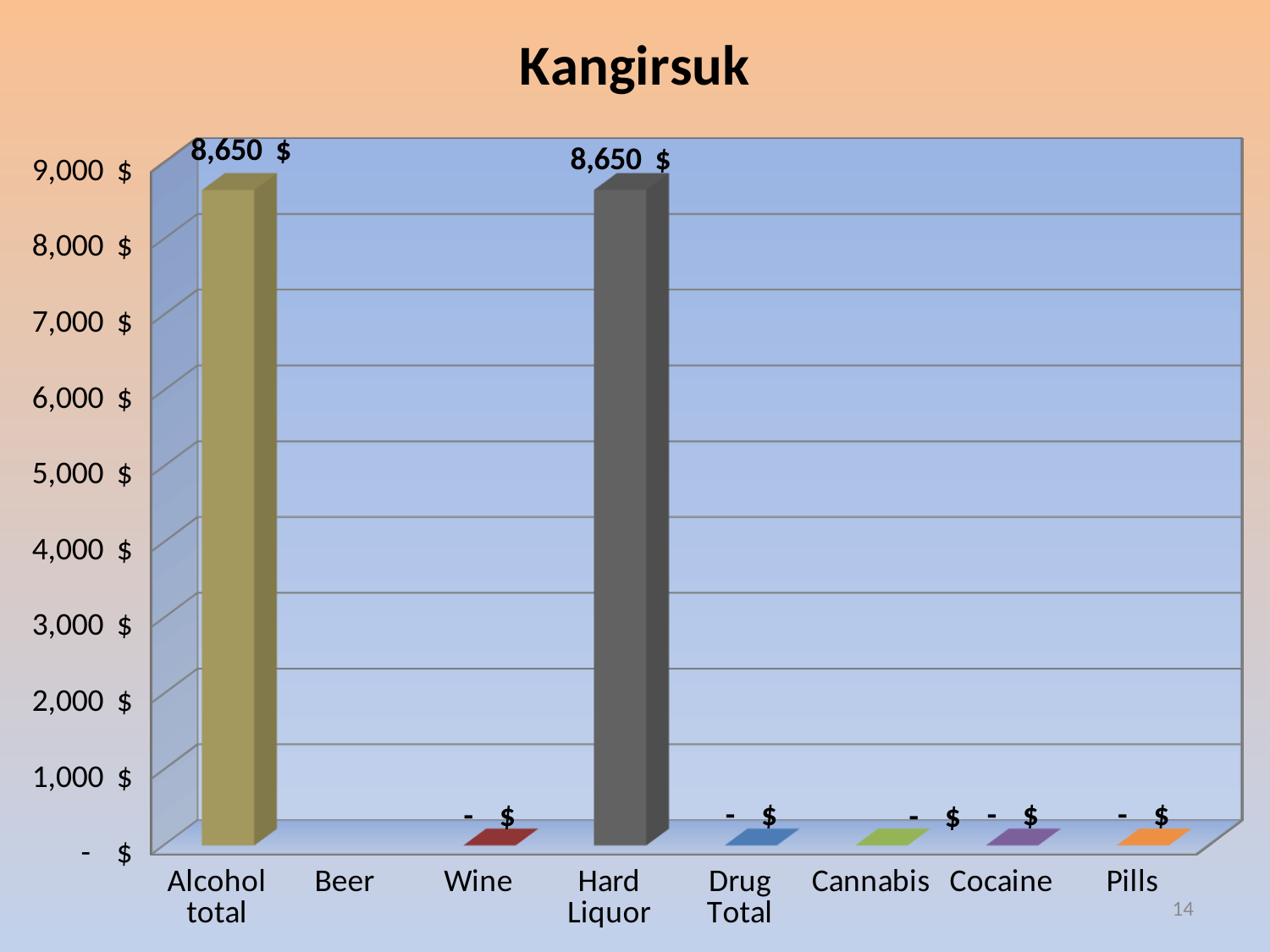
How many categories are shown on the x axis? 8 What is the value shown for Drug Total? - $ What is the value for Alcohol total? 8,650 $ What is the value for Hard Liquor? 8,650 $ Is the value for Alcohol total greater or less than 5,000 $? greater What is the title of the chart? Kangirsuk Which is larger, the value for Hard Liquor or the value for Cannabis? Hard Liquor What kind of chart is shown on the slide? bar chart Is the value for Hard Liquor greater or less than 8,000 $? greater What is the difference between the values for Alcohol total and Hard Liquor? - $ What is the value shown for Pills? - $ What is the value shown for Wine? - $